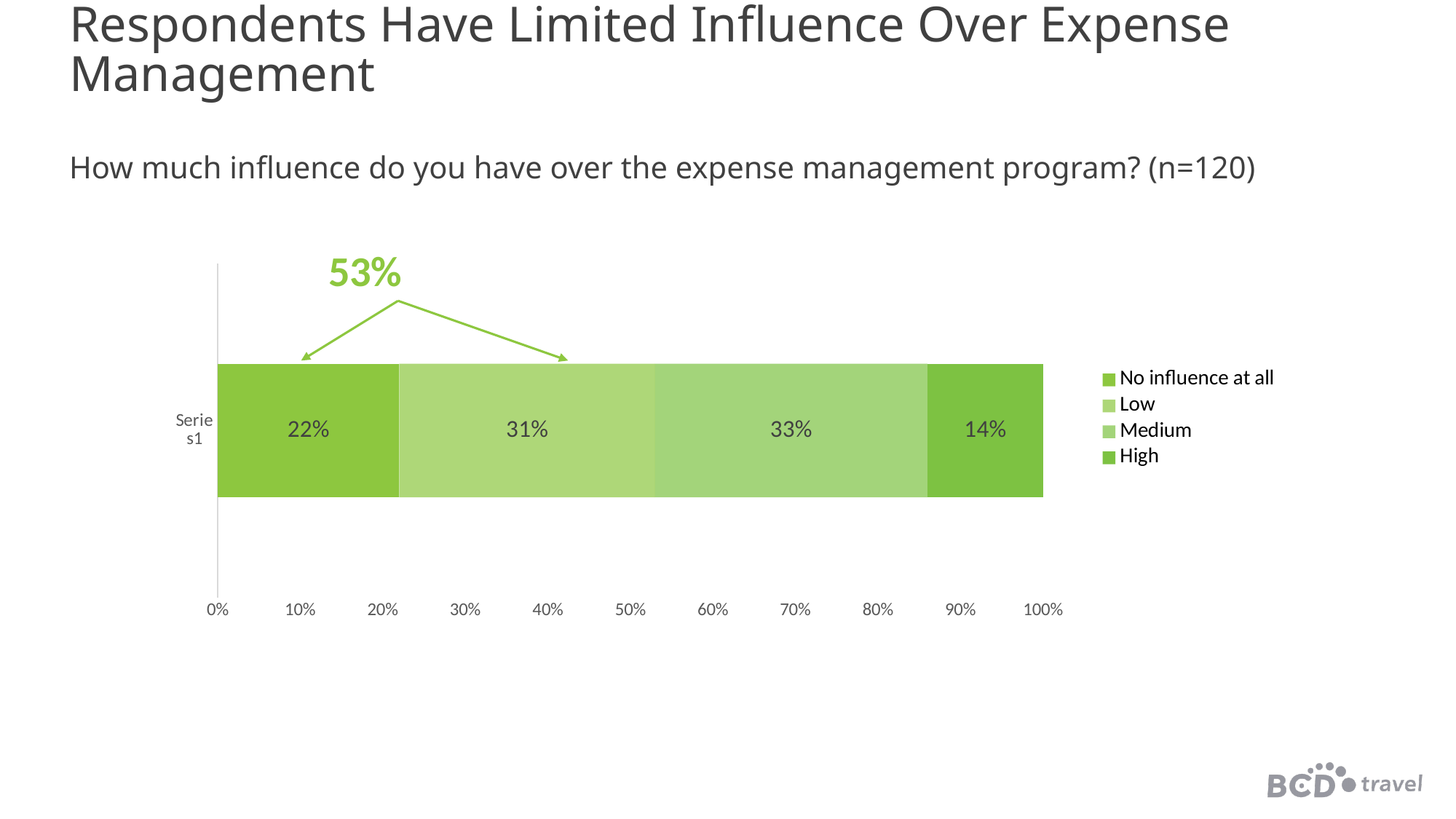
What is the sample size (n) stated in the question above the chart? 120 What kind of chart is shown on the slide? Stacked bar chart What percentage of respondents reported having no influence at all over the expense management program? 22% What percentage of respondents reported High influence? 14% Which influence level has the largest share of respondents? Medium What combined percentage is called out by the annotation above the bar for the No influence at all and Low segments? 53% Which influence level has the smallest share of respondents? High What percentage of respondents reported Low influence? 31% What is the difference in percentage points between the Medium and High segments? 19 What percentage of respondents reported Medium influence? 33% Which is larger, the Low segment or the No influence at all segment? Low How many series does the legend list? 4